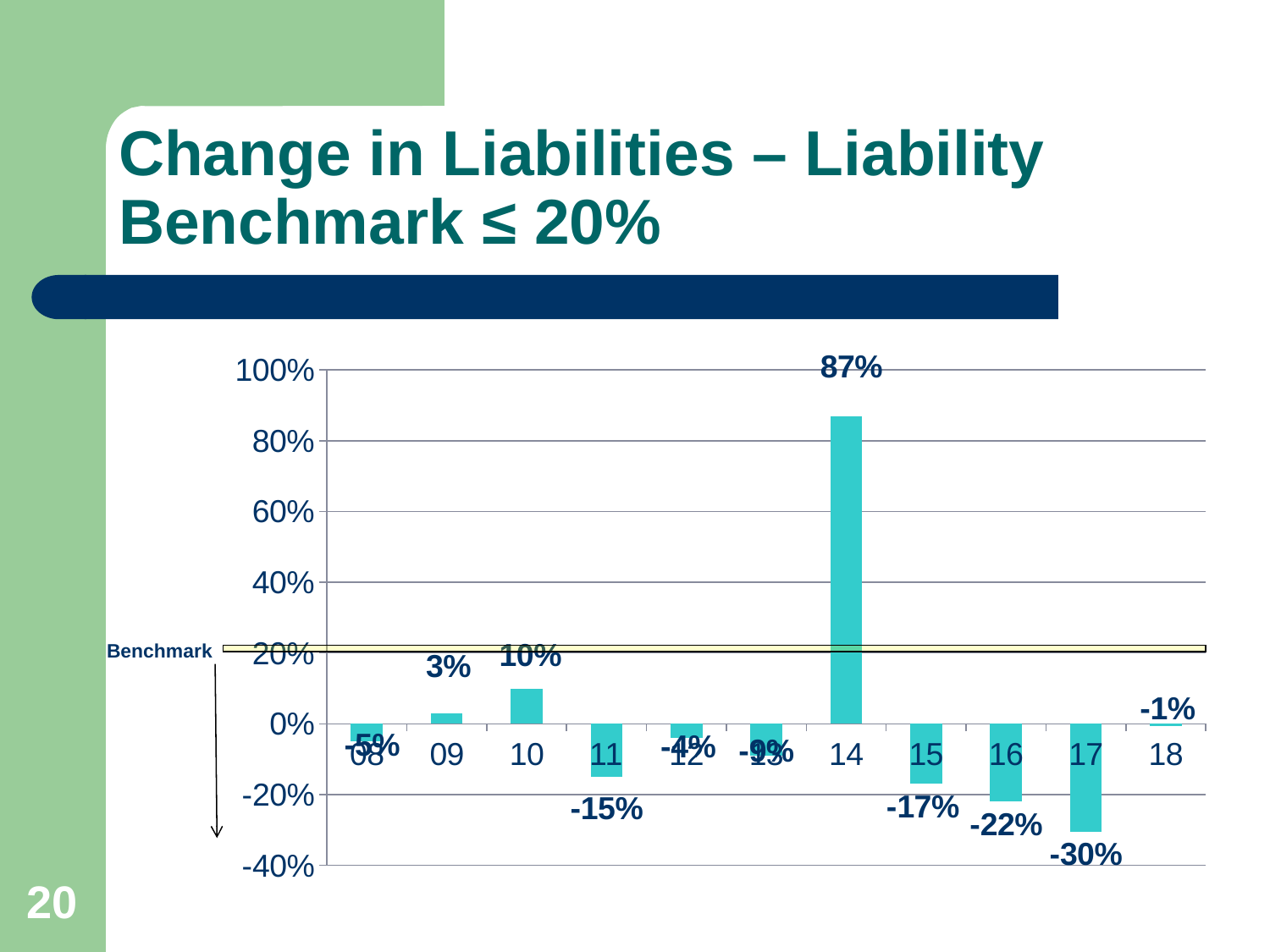
How many years are shown on the x axis? 11 What is the value for 16? -22% What is the value for 14? 87% At what level is the Benchmark line drawn on the chart? 20% What is the value for 17? -30% What is the difference between the values for 14 and 10? 77 percentage points Which year has the highest value? 14 What is the value for 10? 10% Which is larger, the value for 09 or the value for 10? 10 What kind of chart is shown on the slide? bar chart Is the value for 14 greater or less than 80%? greater Which year has the lowest value? 17